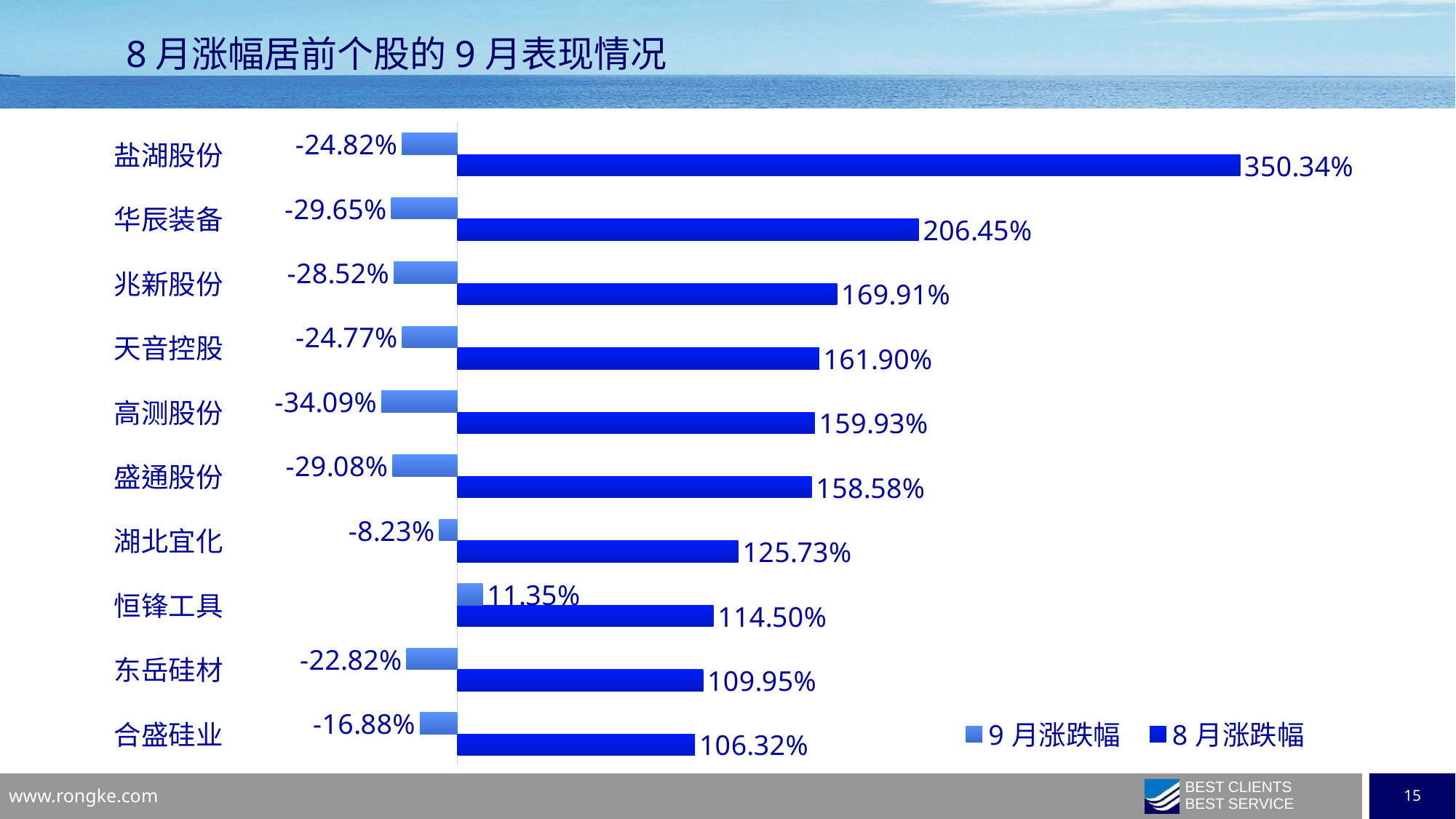
Which is larger, the 8月涨跌幅 of 湖北宜化 or of 恒锋工具? 湖北宜化 What is the 8月涨跌幅 value for 盐湖股份? 350.34% Which stock has the highest 8月涨跌幅? 盐湖股份 What is the difference between the 8月涨跌幅 of 盐湖股份 and 华辰装备? 143.89% Which stock has the lowest 8月涨跌幅? 合盛硅业 Which stock is the only one with a positive 9月涨跌幅? 恒锋工具 What kind of chart is shown on the slide? Bar chart How many series does the legend list? 2 Which stock has the lowest 9月涨跌幅? 高测股份 What is the 9月涨跌幅 value for 恒锋工具? 11.35% How many stocks are shown in the chart? 10 What is the 9月涨跌幅 value for 高测股份? -34.09%